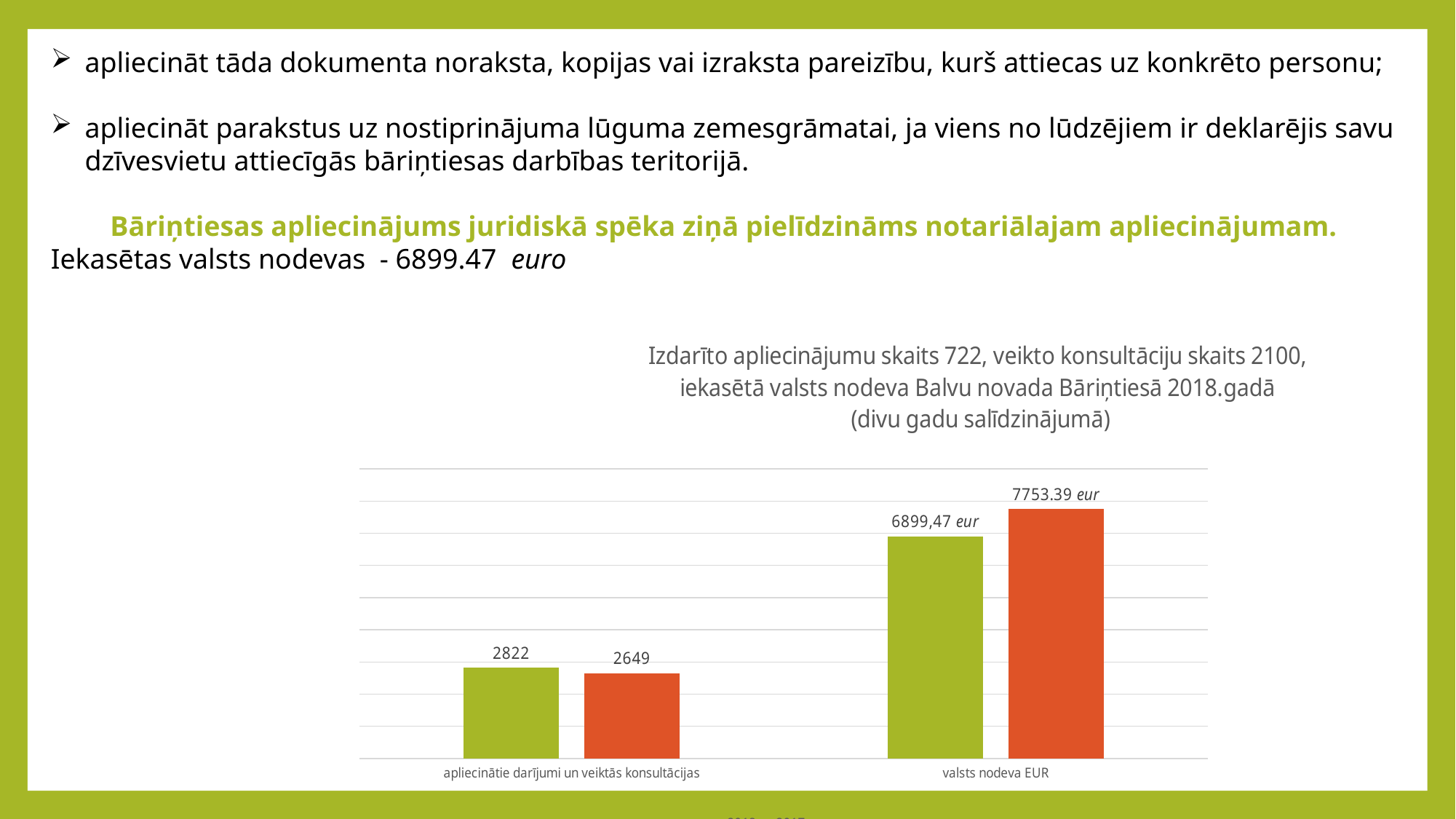
What is the value of the green bar for 'apliecinātie darījumi un veiktās konsultācijas'? 2822 For 'apliecinātie darījumi un veiktās konsultācijas', which bar is larger, the green or the orange one? green For 'valsts nodeva EUR', which bar is larger, the green or the orange one? orange How many categories are shown on the x axis of the chart? 2 What is the difference between the orange and green bars for 'valsts nodeva EUR'? 853.92 Which bar has the lowest value in the chart? the orange bar for apliecinātie darījumi un veiktās konsultācijas (2649) What is the difference between the green and orange bars for 'apliecinātie darījumi un veiktās konsultācijas'? 173 What kind of chart is shown on the slide? bar chart What is the value of the green bar for 'valsts nodeva EUR'? 6899,47 eur What is the value of the orange bar for 'apliecinātie darījumi un veiktās konsultācijas'? 2649 Which bar has the highest value in the chart? the orange bar for valsts nodeva EUR (7753.39 eur) What is the value of the orange bar for 'valsts nodeva EUR'? 7753.39 eur